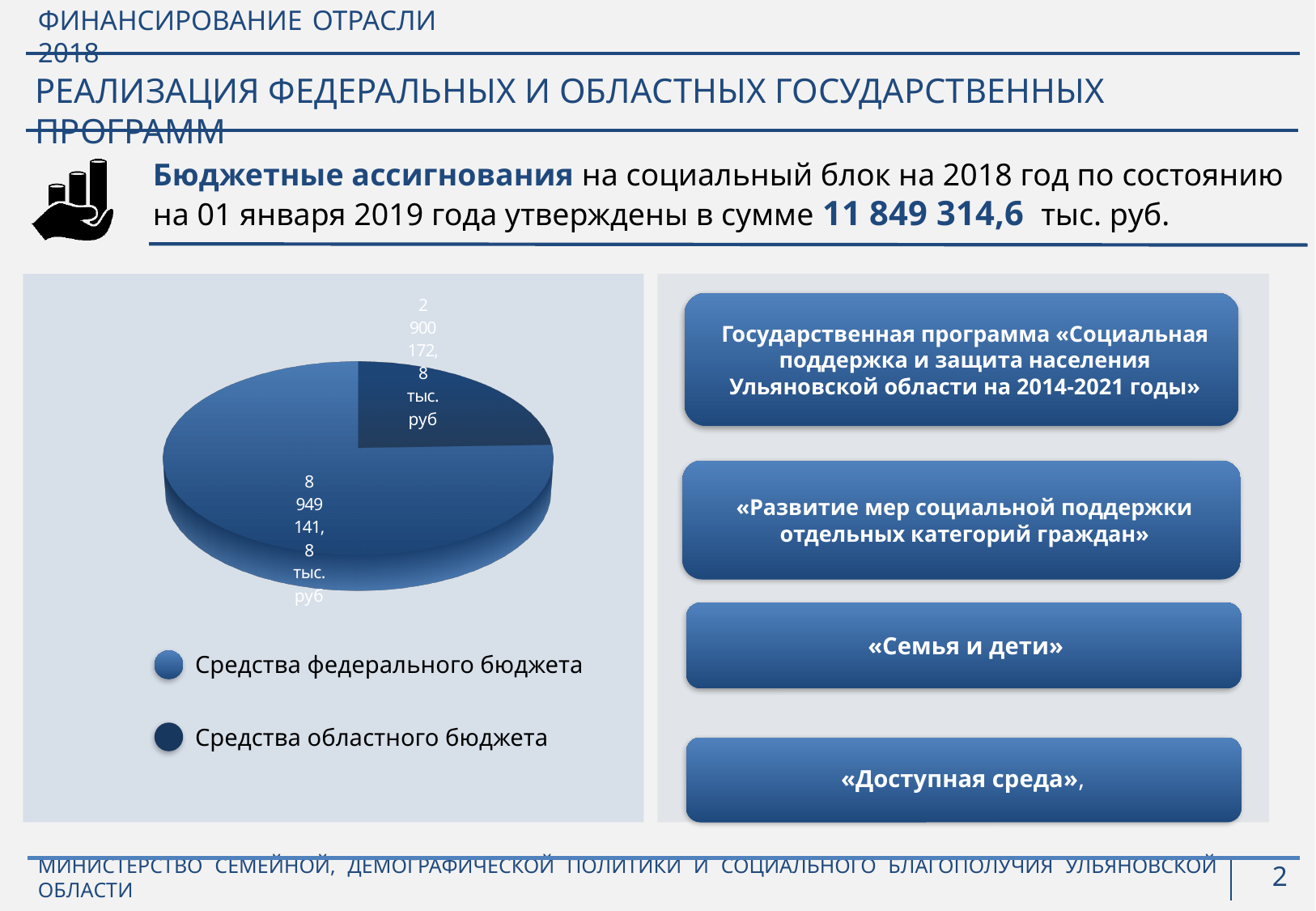
What is the total of the two slices in the pie chart? 11 849 314,6 тыс. руб How many entries does the legend of the pie chart list? 2 What is the value for Средства областного бюджета in the pie chart? 2 900 172,8 тыс. руб Which slice of the pie chart is the smallest? Средства областного бюджета Which legend entry of the pie chart is shown in light blue? Средства федерального бюджета Which is larger in the pie chart: Средства федерального бюджета or Средства областного бюджета? Средства федерального бюджета Which slice of the pie chart is the largest? Средства федерального бюджета What kind of chart is shown on the slide? Pie chart What is the value for Средства федерального бюджета in the pie chart? 8 949 141,8 тыс. руб What is the difference between Средства федерального бюджета and Средства областного бюджета in the pie chart? 6 048 969,0 тыс. руб Which legend entry of the pie chart is shown in dark blue? Средства областного бюджета How many slices does the pie chart have? 2